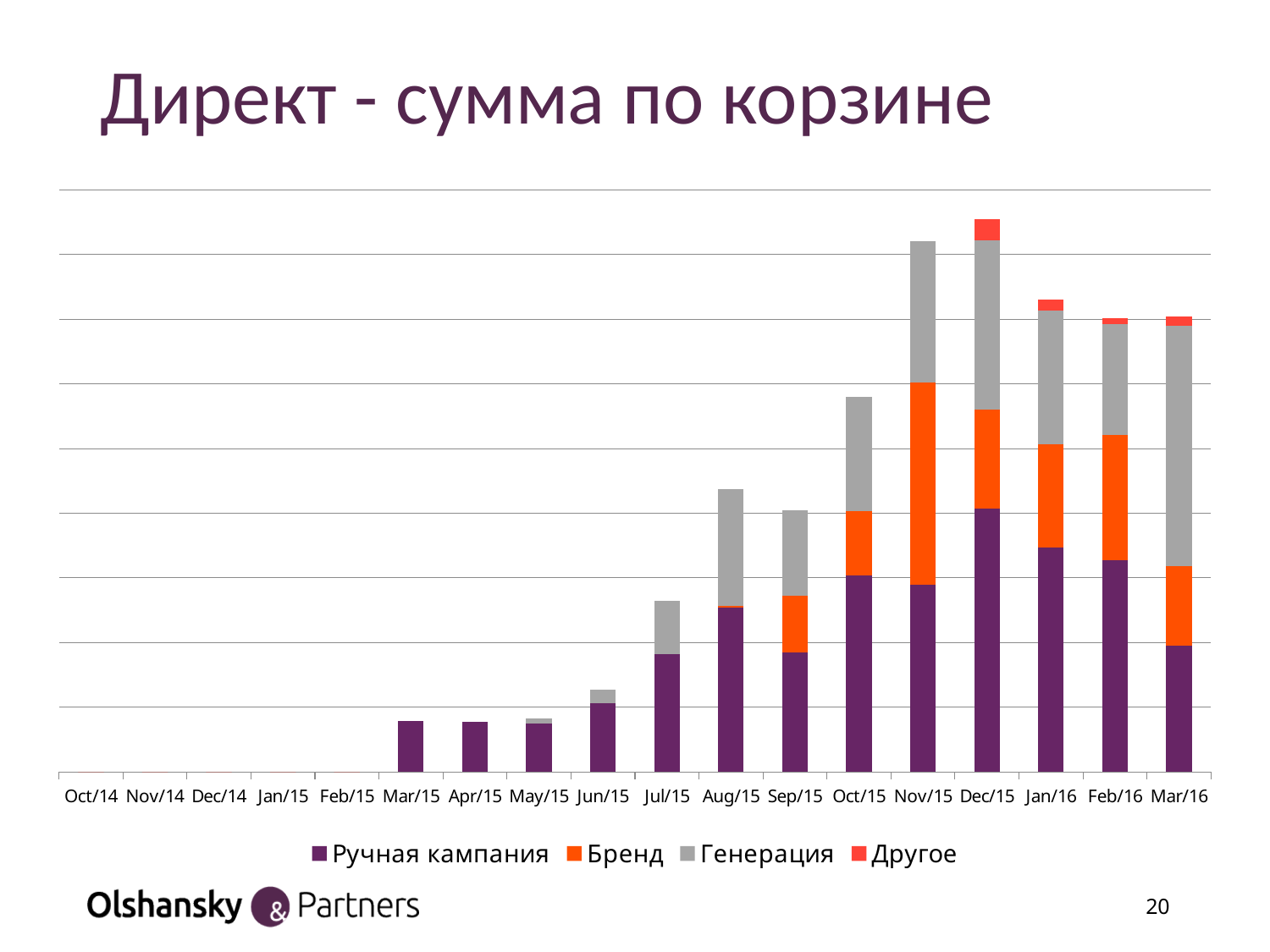
What is the title of the chart? Директ - сумма по корзине Which month has the largest Ручная кампания segment? Dec/15 Which month has the larger total bar, Oct/15 or Sep/15? Oct/15 Which is the first month on the x axis with a clearly visible bar? Mar/15 Do the total bar heights generally rise or fall from Mar/15 to Dec/15? Rise Which month has the larger total bar, Aug/15 or Sep/15? Aug/15 What kind of chart is shown on the slide? Stacked bar chart How many series does the legend list? 4 Which series is shown in gray in the legend? Генерация Which month has the larger Генерация segment, Mar/16 or Feb/16? Mar/16 Which month has the tallest stacked bar overall? Dec/15 How many months are shown on the x axis? 18